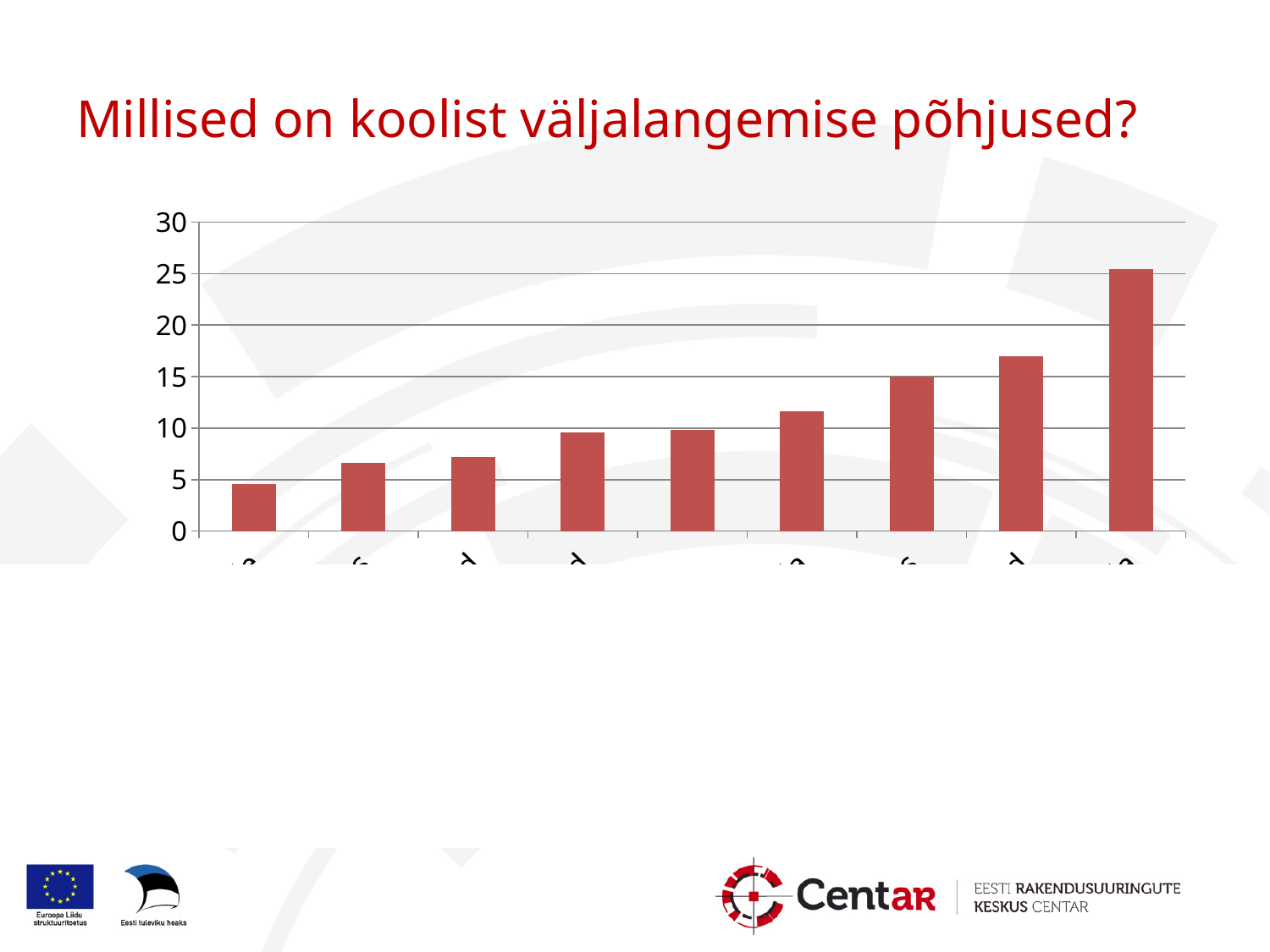
How many bars are plotted in the chart? 9 Which bar is the tallest in the chart? the rightmost bar Is the value of the sixth bar from the left greater or less than 10? greater What kind of chart is shown on the slide? bar chart Which is larger, the rightmost bar or the leftmost bar? the rightmost bar What is the highest value shown on the vertical axis? 30 Is the value of the second bar from the right greater or less than 15? greater Do the bar values rise or fall from left to right along the x axis? rise Is the value of the rightmost bar greater or less than 20? greater Which bar is the shortest in the chart? the leftmost bar What is the title of the slide above the chart? Millised on koolist väljalangemise põhjused?